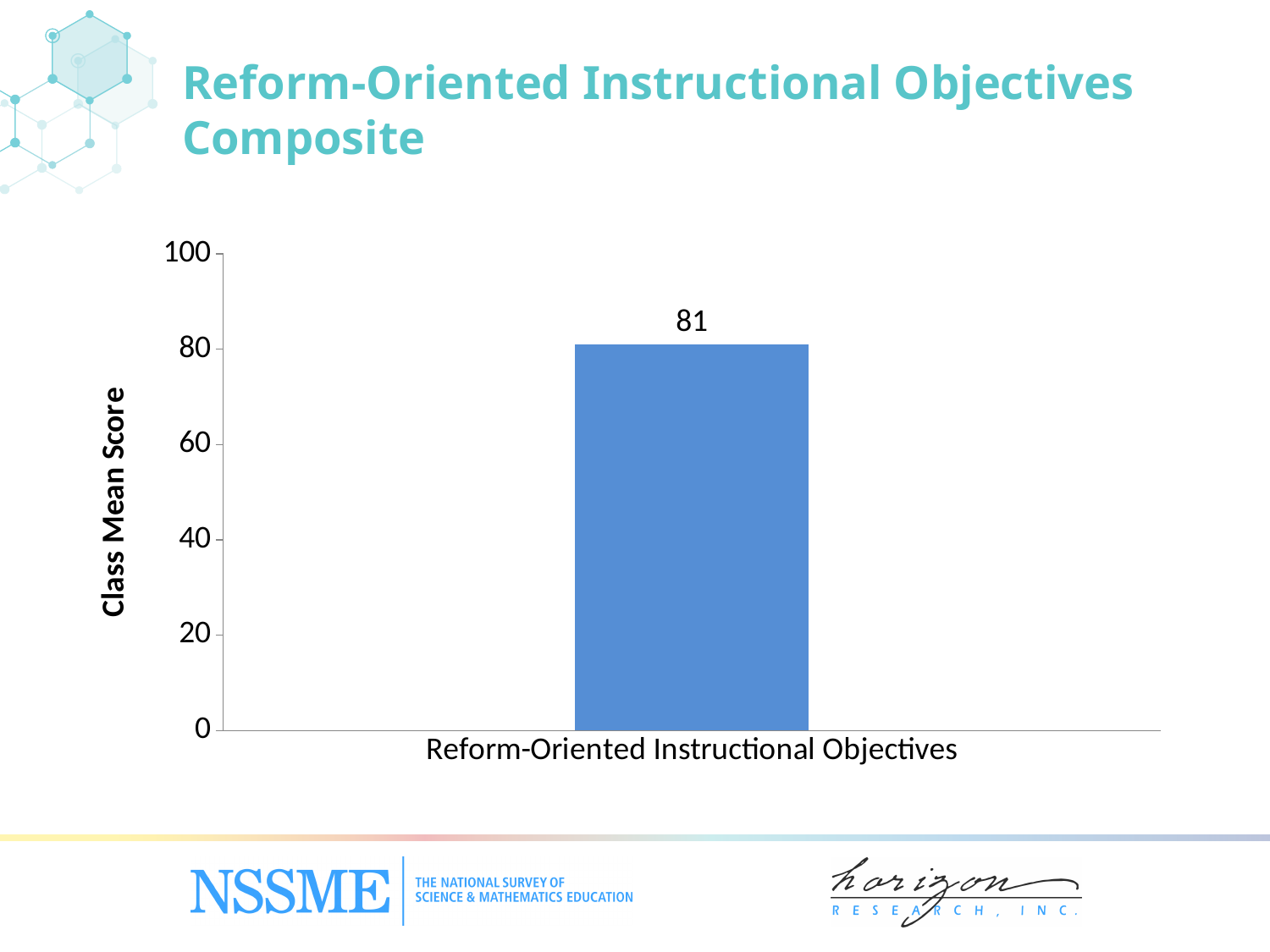
What is the class mean score for Reform-Oriented Instructional Objectives? 81 Is the value for Reform-Oriented Instructional Objectives greater or less than 100? less What kind of chart is shown on the slide? bar chart What is the label on the vertical axis of the chart? Class Mean Score What is the category label shown on the horizontal axis? Reform-Oriented Instructional Objectives How many bars are plotted in the chart? 1 Is the value for Reform-Oriented Instructional Objectives greater or less than 80? greater What is the maximum value shown on the vertical axis? 100